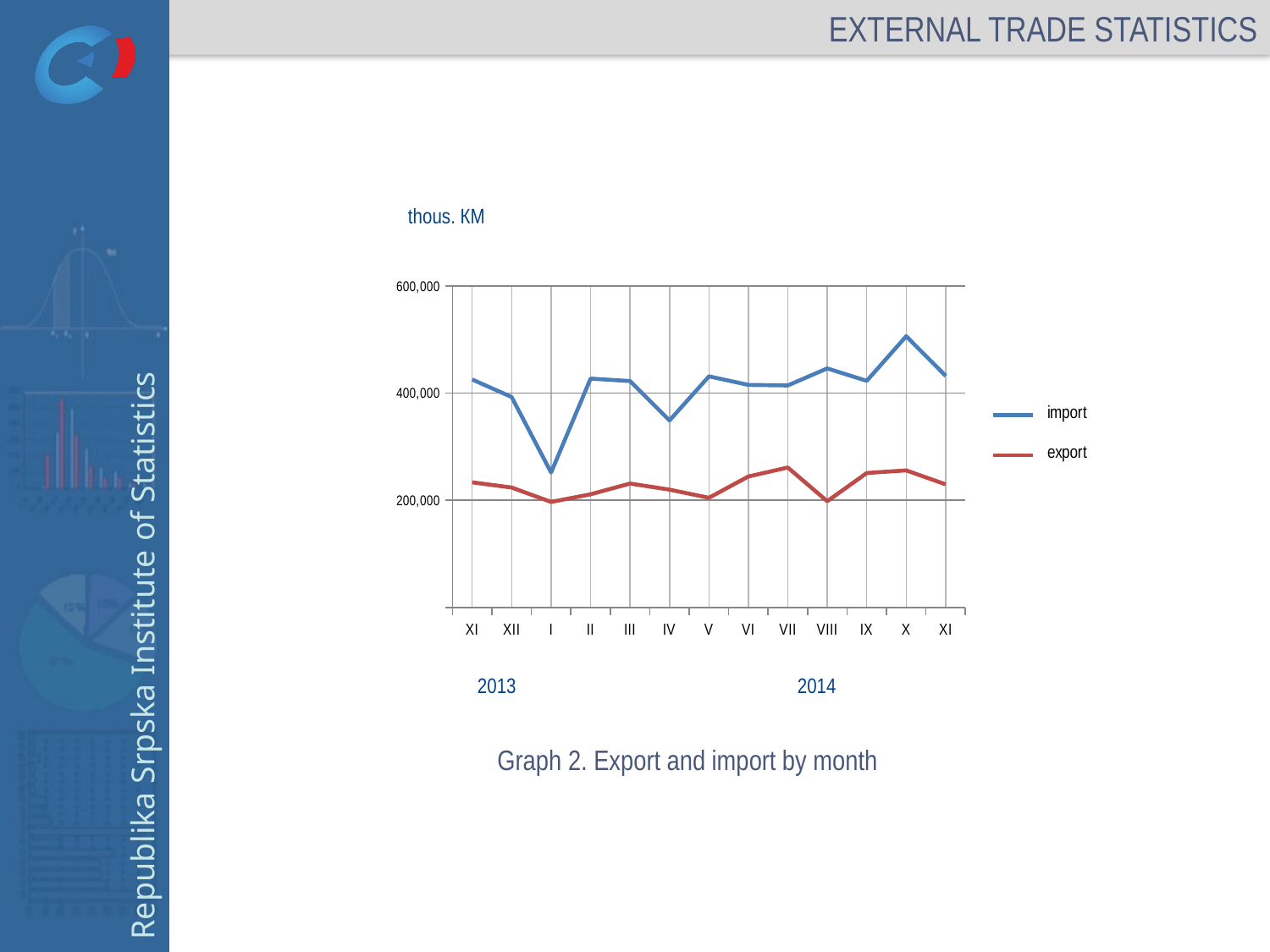
What kind of chart is Graph 2. Export and import by month? line chart How many series does the legend list in Graph 2? 2 How many months are plotted along the x axis of Graph 2? 13 Is the import value for month I of 2014 greater or less than 400,000? less In which month does the import line reach its lowest value in Graph 2? I (2014) In which month does the import line reach its highest value in Graph 2? X (2014) What unit is shown above the chart in Graph 2? thous. KM What colour is the export line in Graph 2? red Does the import line rise or fall from month X to month XI of 2014? fall Is the export value for month VII of 2014 greater or less than 200,000? greater Which is larger in month XI of 2014, import or export? import Is the import value for month X of 2014 greater or less than 400,000? greater